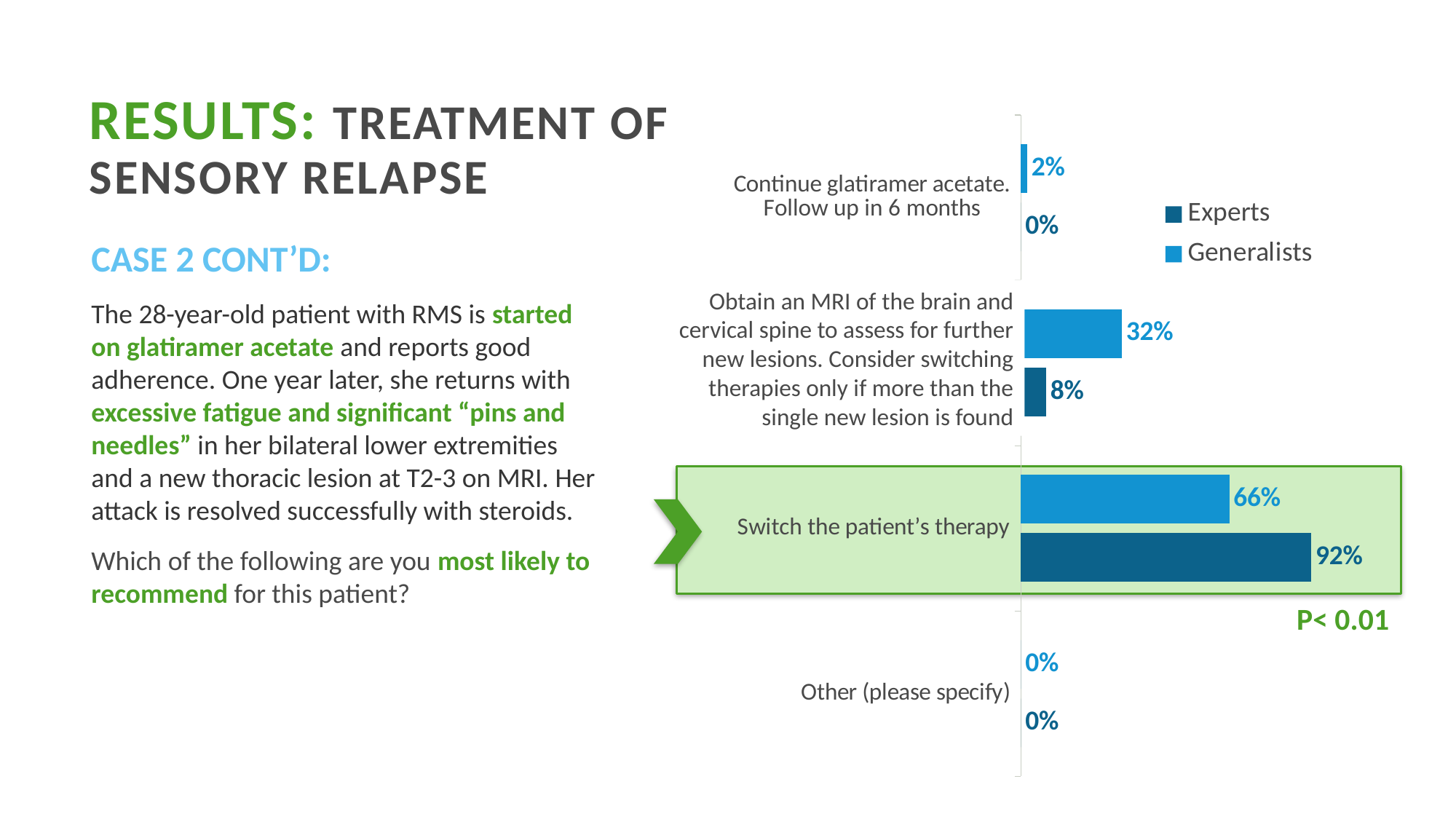
How many series does the legend list? 2 Which response option received the highest percentage from Experts? Switch the patient's therapy What percentage of Generalists chose "Continue glatiramer acetate. Follow up in 6 months"? 2% How many response options are shown on the chart? 4 What percentage of Experts chose "Switch the patient's therapy"? 92% What percentage of Generalists chose to obtain an MRI of the brain and cervical spine? 32% What percentage of Generalists chose "Switch the patient's therapy"? 66% For "Switch the patient's therapy", which group had the larger percentage, Experts or Generalists? Experts What is the difference between the Generalists and Experts percentages for obtaining an MRI of the brain and cervical spine? 24% What is the difference between the Experts and Generalists percentages for "Switch the patient's therapy"? 26% What percentage of Experts chose to obtain an MRI of the brain and cervical spine? 8% What type of chart is shown on the slide? Bar chart